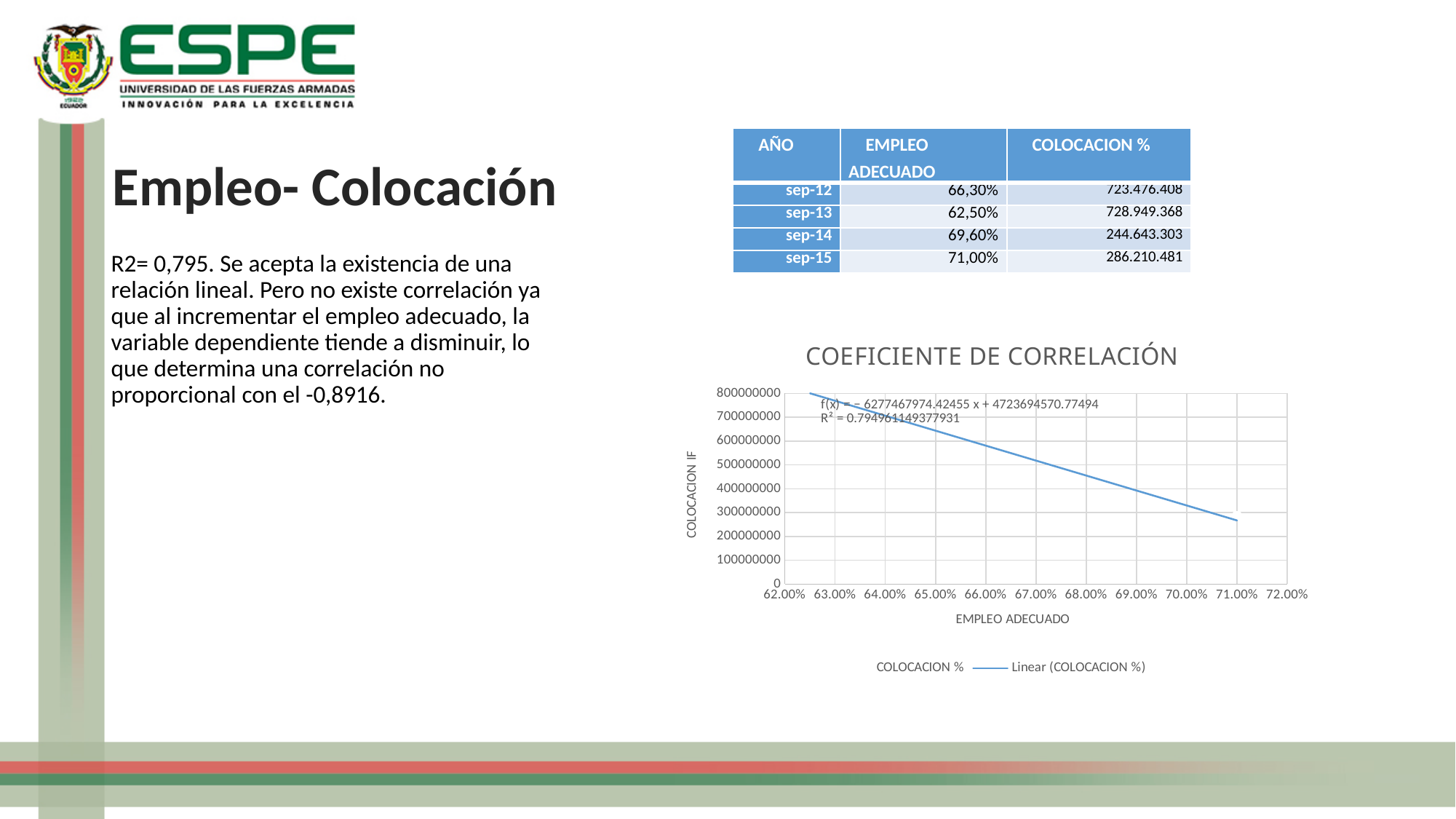
Is the trendline value at 63.00% on the x axis greater or less than 700000000? greater What is the title of the chart on the slide? COEFICIENTE DE CORRELACIÓN Does the trendline in the chart rise or fall as EMPLEO ADECUADO increases along the x axis? fall What is the highest value shown on the y axis of the chart? 800000000 What is the label of the x axis of the chart? EMPLEO ADECUADO What is the trendline equation printed on the chart? f(x) = − 6277467974.42455 x + 4723694570.77494 What kind of chart is shown under the title "COEFICIENTE DE CORRELACIÓN"? scatter chart with a linear trendline Is the trendline value at 71.00% on the x axis greater or less than 300000000? less How many tick labels are shown on the x axis of the chart? 11 How many entries does the chart legend list? 2 What is the R² value printed on the chart? 0.794961149377931 What is the lowest value shown on the x axis of the chart? 62.00%